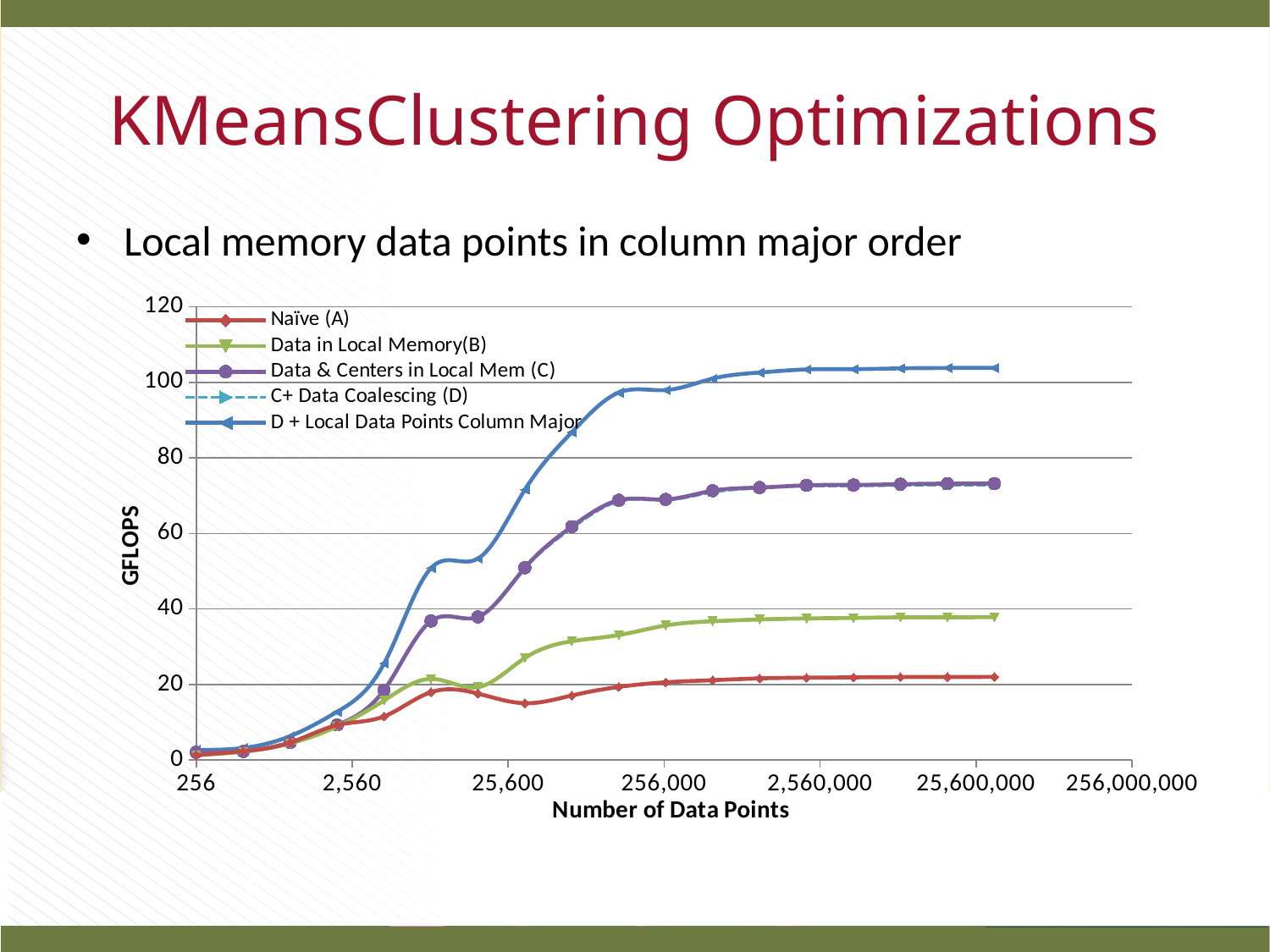
Is the value for Data in Local Memory(B) at its right-hand end greater or less than 40? less Which series reaches the highest GFLOPS at the largest number of data points? D + Local Data Points Column Major Which series has the lowest GFLOPS at the largest number of data points? Naïve (A) Is the value for Naïve (A) at its right-hand end greater or less than 20? greater How many series does the chart's legend list? 5 What is the label of the x axis? Number of Data Points Do the GFLOPS values for D + Local Data Points Column Major generally rise or fall as the number of data points increases? rise Is the value for Data & Centers in Local Mem (C) at its right-hand end greater or less than 80? less What is the label of the y axis? GFLOPS At the largest number of data points, which series has the larger value: Data in Local Memory(B) or Data & Centers in Local Mem (C)? Data & Centers in Local Mem (C) What kind of chart is shown on the slide? line chart